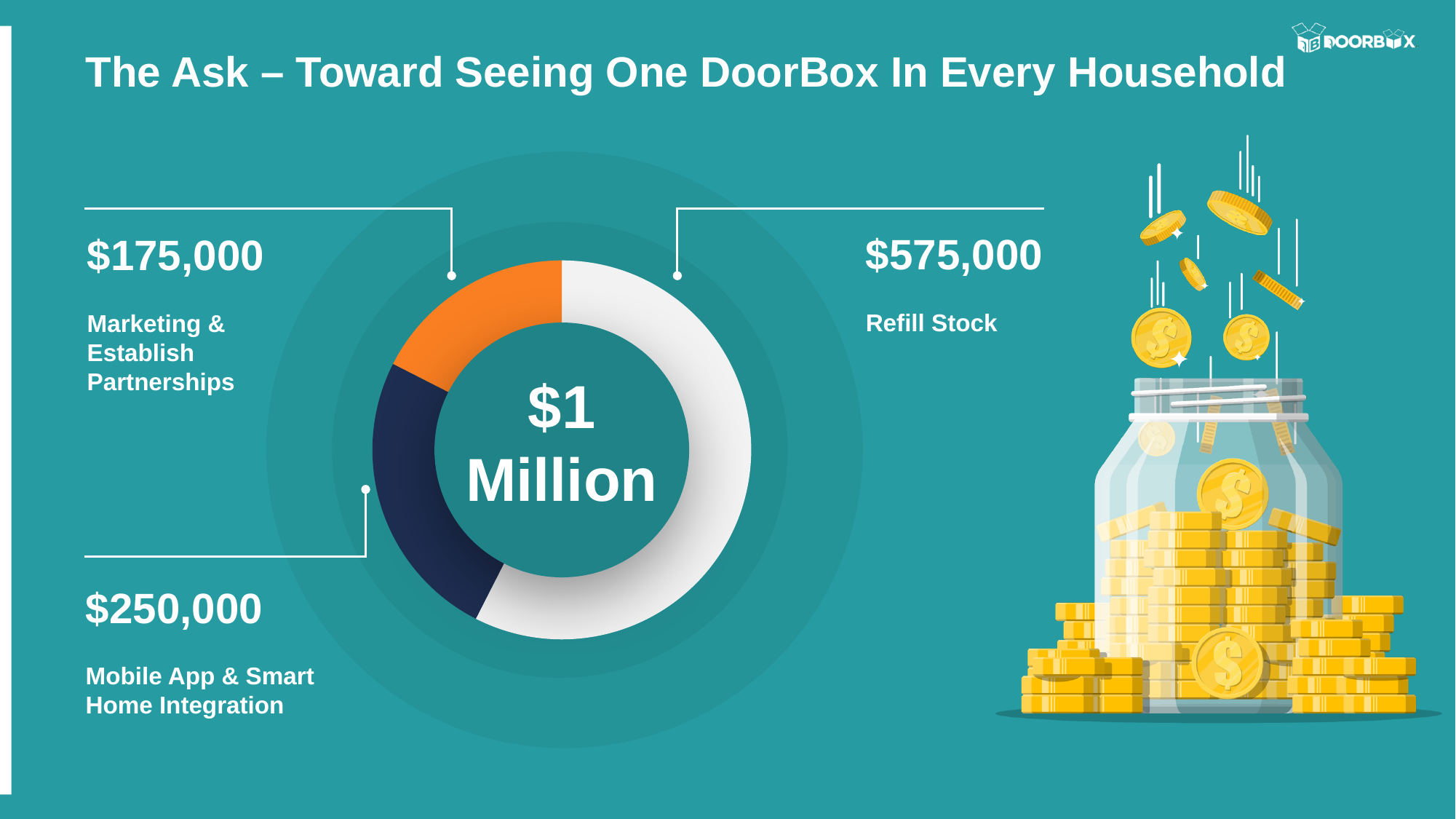
What is the value for Mobile App & Smart Home Integration? $250,000 What is the value for Refill Stock? $575,000 Which category has the largest value? Refill Stock How many categories does the chart show? 3 What is the difference between the Refill Stock value and the Marketing & Establish Partnerships value? $400,000 What is the value for Marketing & Establish Partnerships? $175,000 What total amount is shown in the centre of the chart? $1 Million What kind of chart is shown on the slide? Donut chart Which is larger, Mobile App & Smart Home Integration or Marketing & Establish Partnerships? Mobile App & Smart Home Integration What is the difference between the Mobile App & Smart Home Integration value and the Marketing & Establish Partnerships value? $75,000 Which category has the smallest value? Marketing & Establish Partnerships What share of the $1 Million total does Refill Stock represent? 57.5%